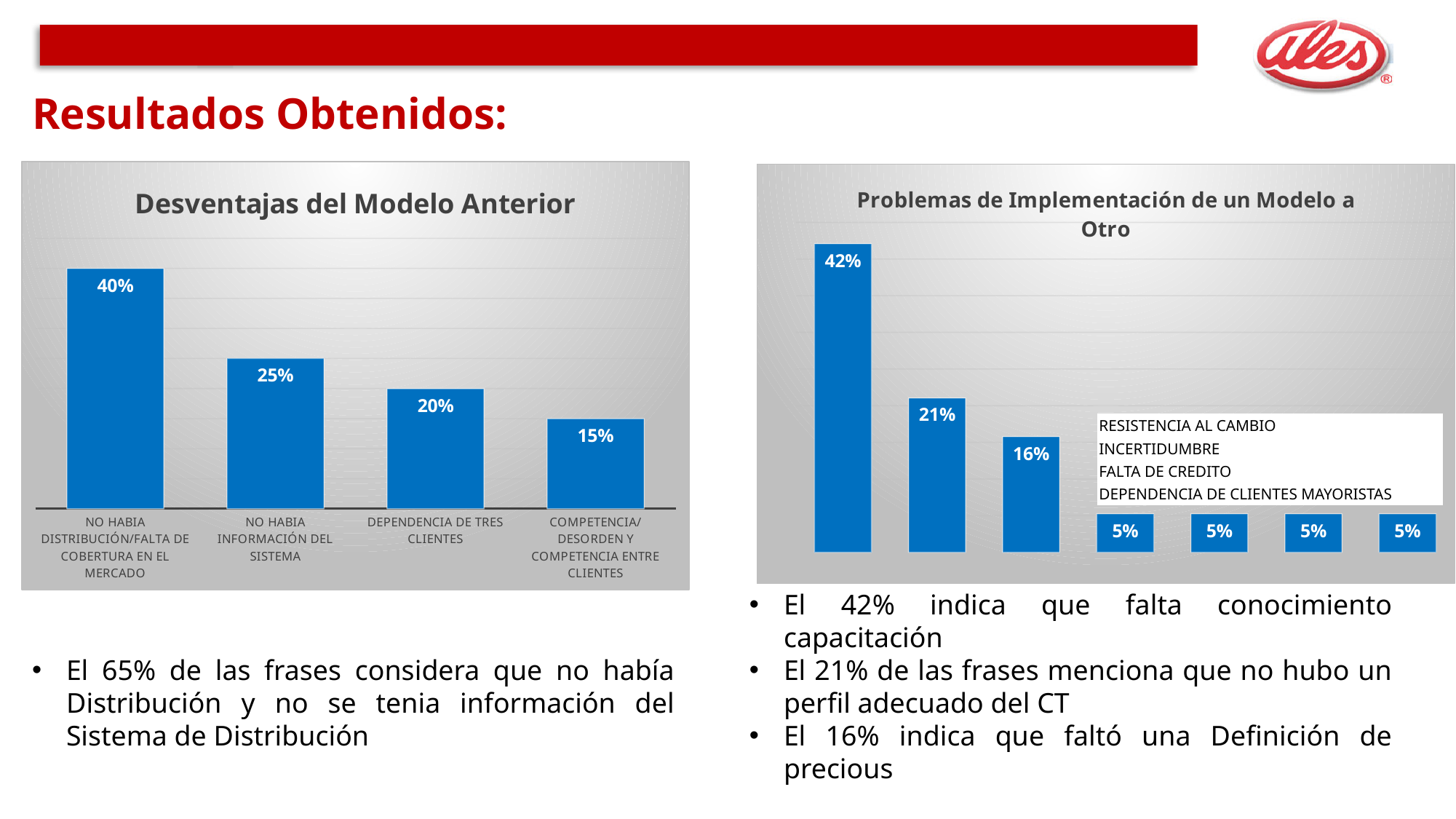
In the 'Problemas de Implementación de un Modelo a Otro' chart, how many bars are shown? 7 What kind of chart is 'Desventajas del Modelo Anterior'? bar chart In the 'Problemas de Implementación de un Modelo a Otro' chart, what is the difference between the first bar (42%) and the second bar (21%)? 21% In the 'Desventajas del Modelo Anterior' chart, what is the value for 'NO HABIA INFORMACIÓN DEL SISTEMA'? 25% In the 'Problemas de Implementación de un Modelo a Otro' chart, what is the value of the tallest bar? 42% In the 'Desventajas del Modelo Anterior' chart, how many categories are shown? 4 In the 'Problemas de Implementación de un Modelo a Otro' chart, what value do the four smallest bars each show? 5% In the 'Desventajas del Modelo Anterior' chart, which category has the lowest value? COMPETENCIA/DESORDEN Y COMPETENCIA ENTRE CLIENTES In the 'Desventajas del Modelo Anterior' chart, which category has the highest value? NO HABIA DISTRIBUCIÓN/FALTA DE COBERTURA EN EL MERCADO In the 'Desventajas del Modelo Anterior' chart, what is the value for 'DEPENDENCIA DE TRES CLIENTES'? 20% In the 'Desventajas del Modelo Anterior' chart, what is the difference between the values for 'NO HABIA DISTRIBUCIÓN/FALTA DE COBERTURA EN EL MERCADO' and 'COMPETENCIA/DESORDEN Y COMPETENCIA ENTRE CLIENTES'? 25% In the 'Desventajas del Modelo Anterior' chart, do the values rise or fall from left to right? fall